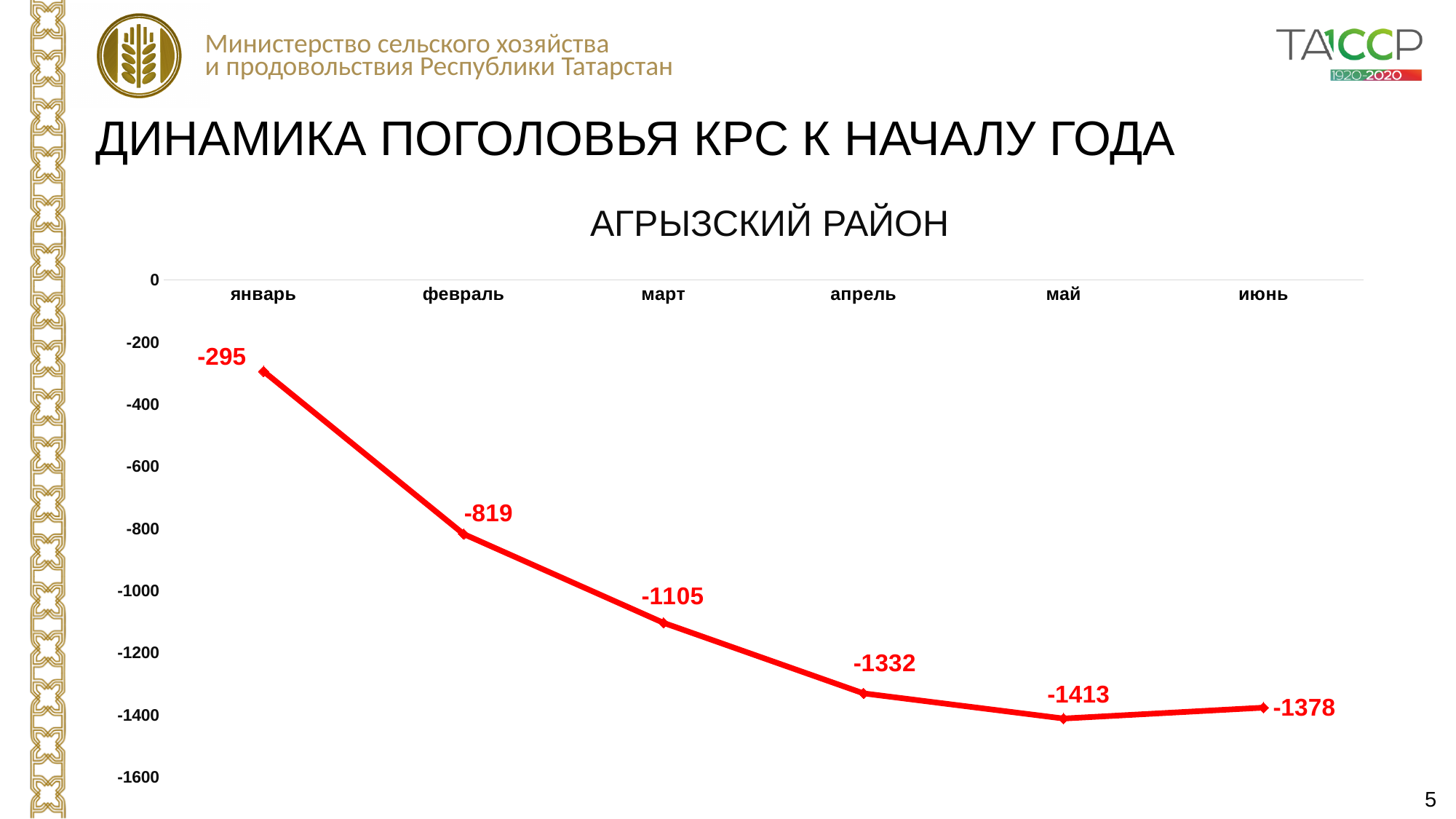
What is the difference between the values for февраль and март? 286 Do the values rise or fall from январь to май? fall What is the difference between the values for май and июнь? 35 Which is larger, the value for март or the value for апрель? март What is the value for июнь? -1378 What is the value for апрель? -1332 What kind of chart is shown on the slide? line chart Which month has the highest value? январь What is the value for январь? -295 Which month has the lowest value? май Is the value for февраль greater or less than -1000? greater How many months are plotted on the chart? 6